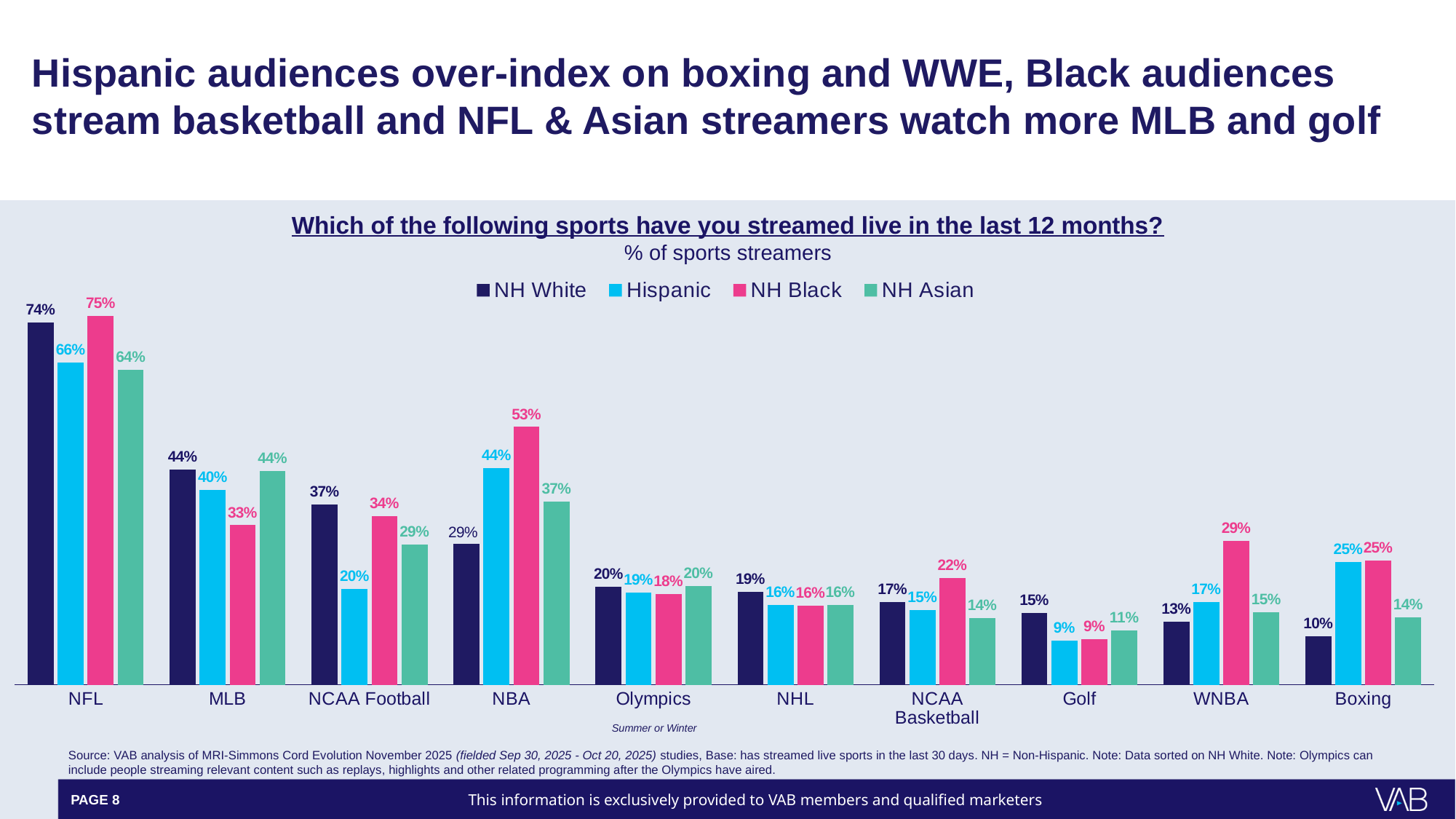
How many series does the legend list? 4 How many sports categories are shown on the x axis? 10 Do the NH White values rise or fall moving from NFL to Boxing along the x axis? Fall What is the difference between the NH Black and NH White values for the WNBA? 16% What is the NH Asian value for Golf? 11% For Boxing, which is larger: the Hispanic value or the NH White value? Hispanic Which sport has the highest NH White value? NFL What percentage of Hispanic sports streamers streamed the NFL live? 66% Which sport has the lowest NH White value? Boxing What is the subtitle shown under the chart title? % of sports streamers What is the NH Black value for the NBA? 53% What kind of chart is shown on the slide? Bar chart